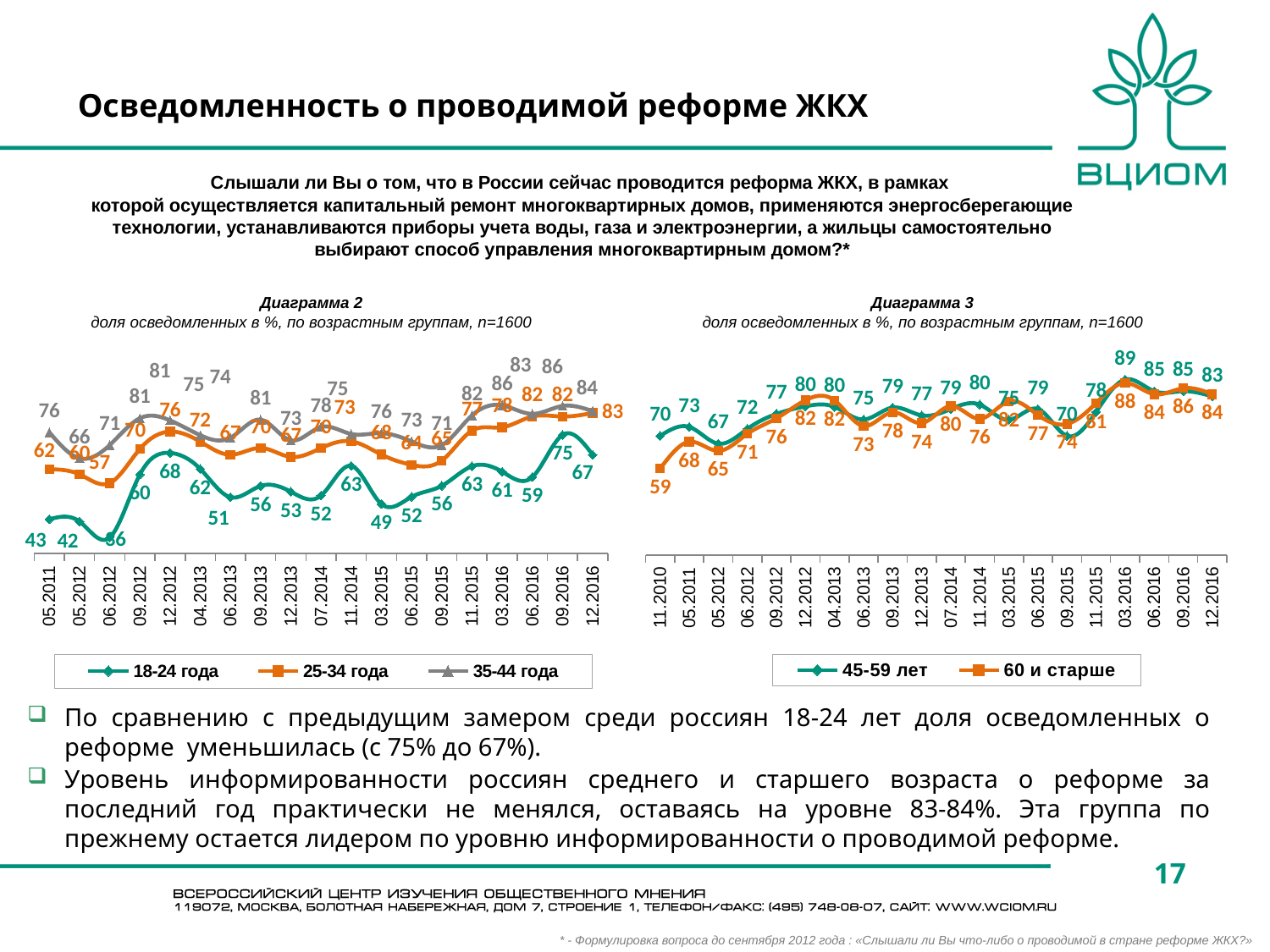
In Диаграмма 2, what is the value for the 35-44 года series at 12.2016? 84 In Диаграмма 2, by how much did the 18-24 года value fall from 09.2016 to 12.2016? 8 In Диаграмма 2, what is the value for the 18-24 года series at 12.2016? 67 In Диаграмма 3, how many dates are shown on the x axis? 20 In Диаграмма 3, what is the value for the 45-59 лет series at 12.2016? 83 In Диаграмма 3, how many series does the legend list? 2 In Диаграмма 2, at 12.2016, which is larger: the 35-44 года value or the 18-24 года value? 35-44 года In Диаграмма 3, what is the value for the 60 и старше series at 11.2010? 59 In Диаграмма 2, what is the lowest value of the 18-24 года series, and at which date? 36, at 06.2012 What type of chart is Диаграмма 3? Line chart In Диаграмма 2, how many series does the legend list? 3 In Диаграмма 3, what is the highest value of the 45-59 лет series, and at which date? 89, at 03.2016